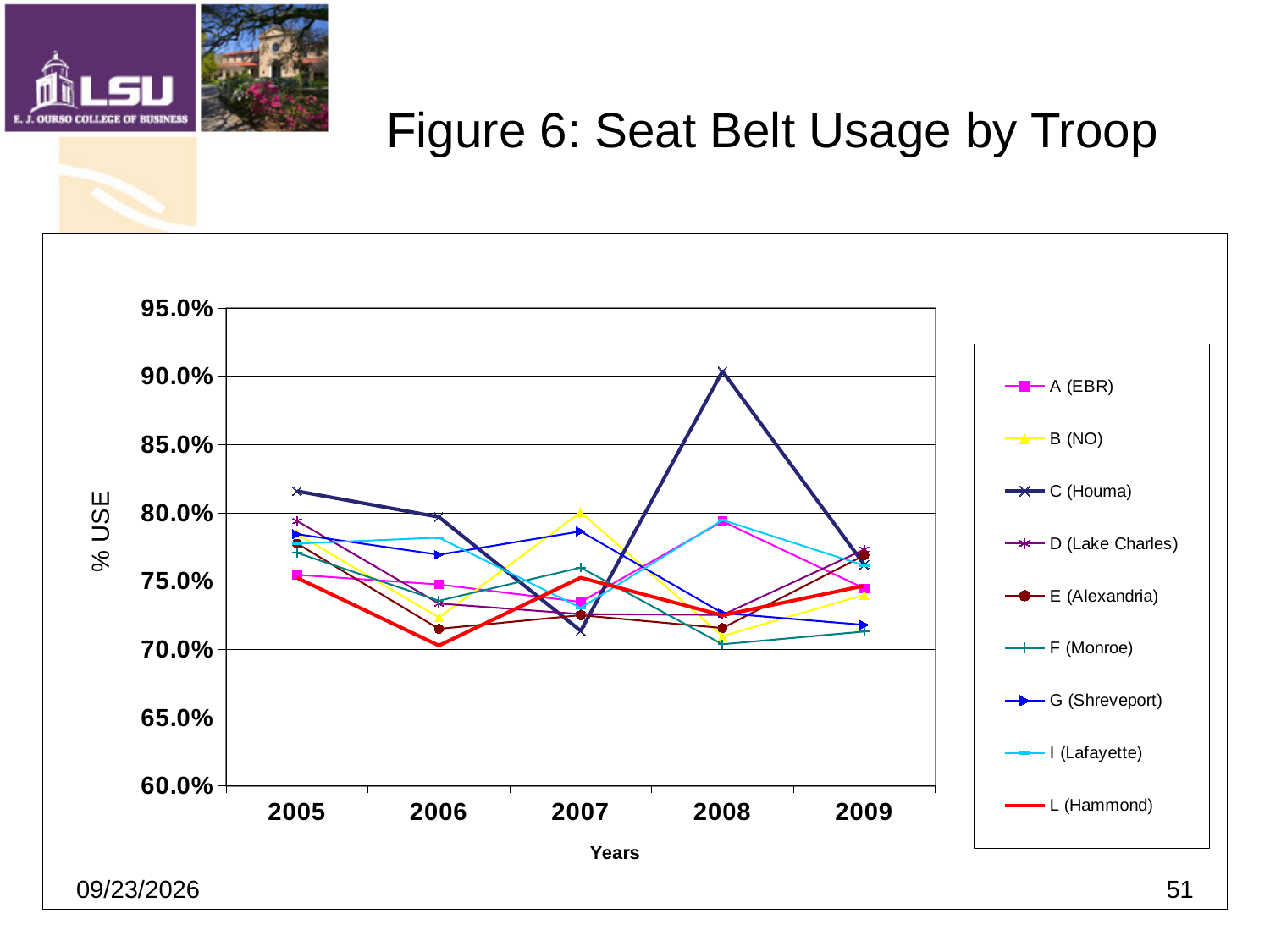
In 2008, which is larger: the value for C (Houma) or the value for L (Hammond)? C (Houma) Is the value for A (EBR) in 2008 greater or less than 75.0%? greater Which troop has the highest seat belt usage in 2008? C (Houma) Is the value for C (Houma) in 2008 greater or less than 85.0%? greater Is the value for L (Hammond) in 2006 greater or less than 75.0%? less Does the value for C (Houma) rise or fall from 2008 to 2009? fall What is the title of the chart? Figure 6: Seat Belt Usage by Troop How many years are shown along the x axis? 5 What kind of chart is shown on the slide? line chart How many series does the legend list? 9 Which troop has the highest seat belt usage in 2005? C (Houma)